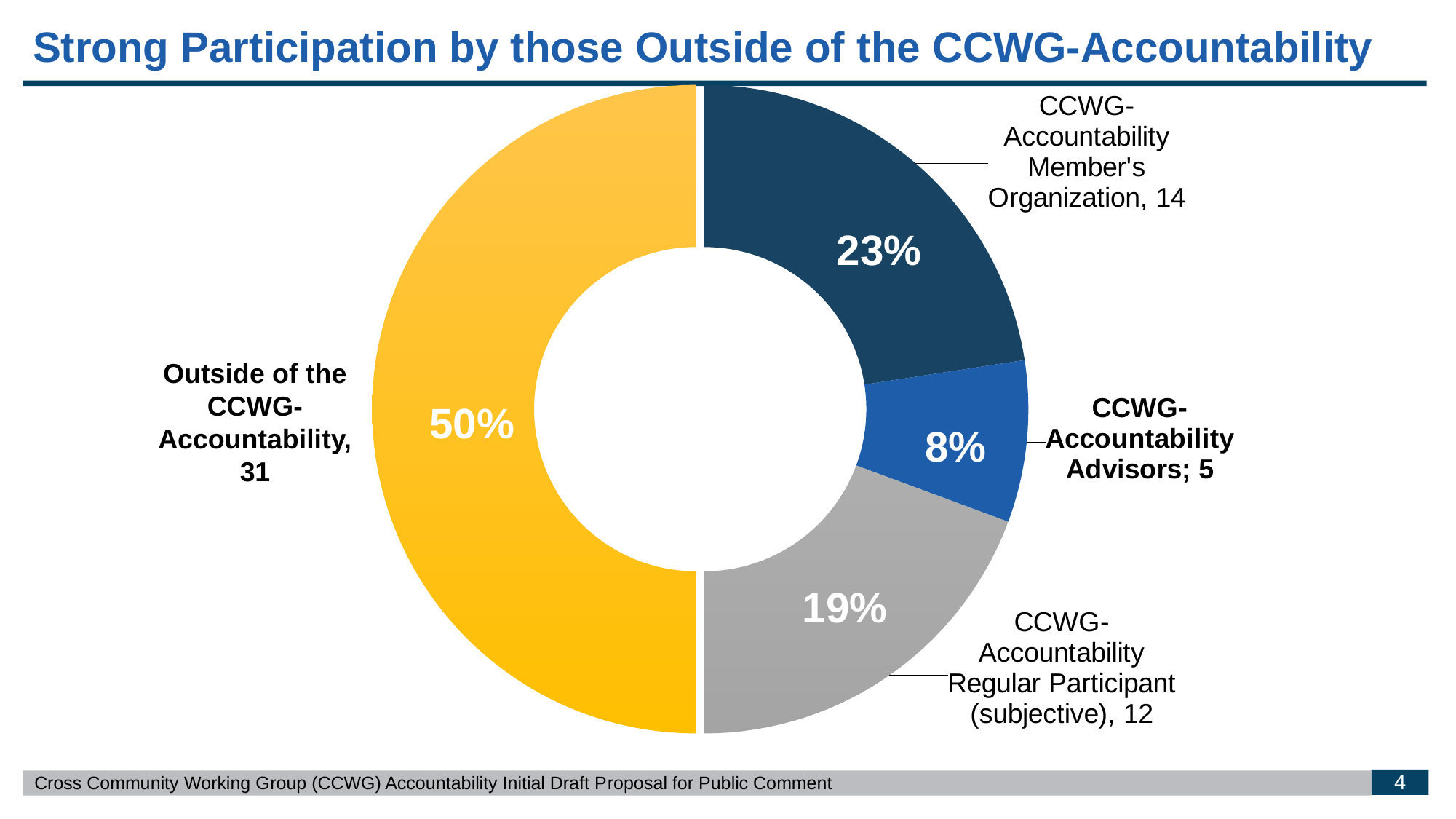
Which category has the smallest share of the chart? CCWG-Accountability Advisors What is the value for CCWG-Accountability Advisors? 5 Which category has the largest share of the chart? Outside of the CCWG-Accountability What is the value for Outside of the CCWG-Accountability? 31 What is the value for CCWG-Accountability Member's Organization? 14 What share of the chart does CCWG-Accountability Regular Participant (subjective) represent? 19% What is the value for CCWG-Accountability Regular Participant (subjective)? 12 What kind of chart is shown on the slide? Doughnut chart What is the difference between the values for CCWG-Accountability Member's Organization and CCWG-Accountability Advisors? 9 What share of the chart does Outside of the CCWG-Accountability represent? 50% What is the title of the slide containing the chart? Strong Participation by those Outside of the CCWG-Accountability How many categories does the chart show? 4